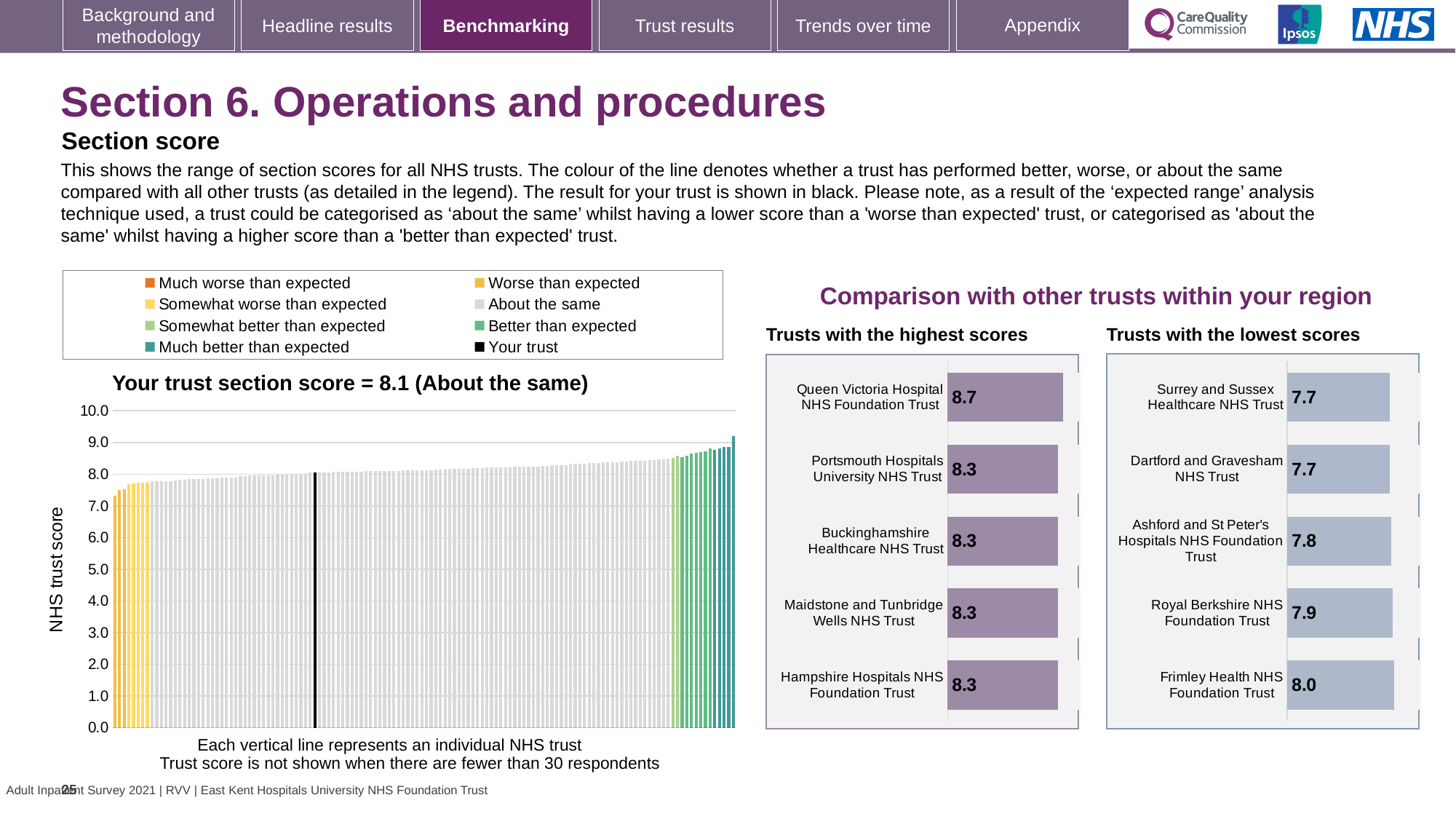
In the 'Trusts with the lowest scores' chart, what is the score for Frimley Health NHS Foundation Trust? 8.0 What kind of chart is the 'Your trust section score' chart? bar chart How many entries does the legend above the 'Your trust section score' chart list? 8 How many trusts are shown in the 'Trusts with the lowest scores' chart? 5 In the 'Your trust section score' chart, what category is your trust placed in? About the same In the 'Your trust section score' chart, is the value of the tallest bar greater or less than 9.0? greater In the 'Trusts with the highest scores' chart, what is the score for Queen Victoria Hospital NHS Foundation Trust? 8.7 In the 'Your trust section score' chart, do the trust scores rise or fall from left to right? rise In the 'Trusts with the highest scores' chart, what is the difference between the scores of Queen Victoria Hospital NHS Foundation Trust and Hampshire Hospitals NHS Foundation Trust? 0.4 In the 'Your trust section score' chart, what is the section score for your trust? 8.1 In the 'Trusts with the lowest scores' chart, which has the larger score: Royal Berkshire NHS Foundation Trust or Ashford and St Peter's Hospitals NHS Foundation Trust? Royal Berkshire NHS Foundation Trust In the 'Trusts with the highest scores' chart, which trust has the highest score? Queen Victoria Hospital NHS Foundation Trust